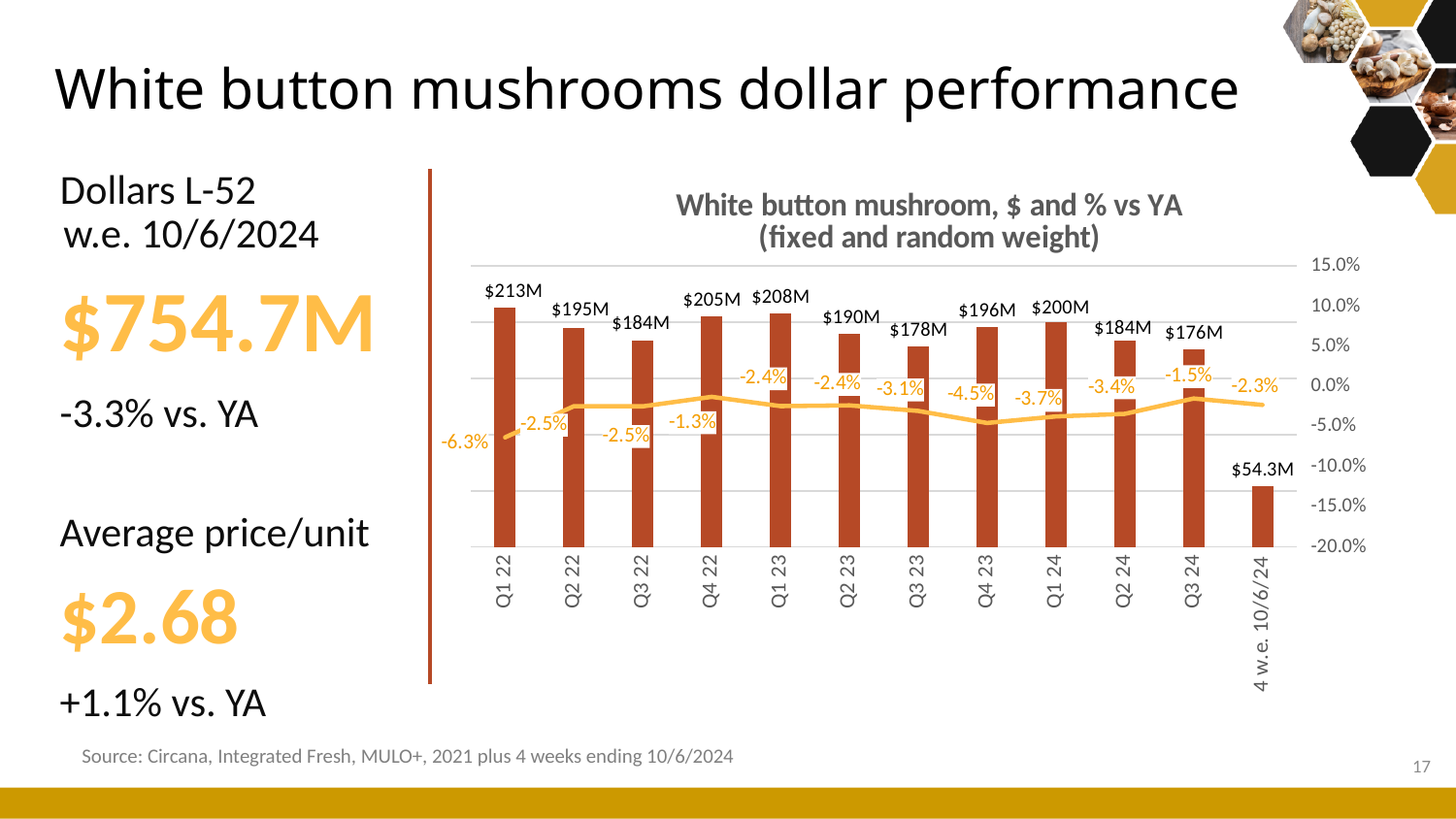
What is the title of the chart? White button mushroom, $ and % vs YA (fixed and random weight) What kind of chart is this? Bar chart with a line What is the dollar value for the 4 w.e. 10/6/24 period? $54.3M Which has a larger dollar value, Q4 22 or Q1 23? Q1 23 How many periods are shown on the x axis? 12 What is the % vs YA value for Q4 23? -4.5% Does the % vs YA line rise or fall from Q4 23 to Q3 24? Rise What is the difference in dollar value between Q1 22 and Q2 22? $18M Which period has the highest dollar value? Q1 22 What is the dollar value for Q1 22? $213M Which period has the highest % vs YA value? Q4 22 Which period has the lowest % vs YA value? Q1 22